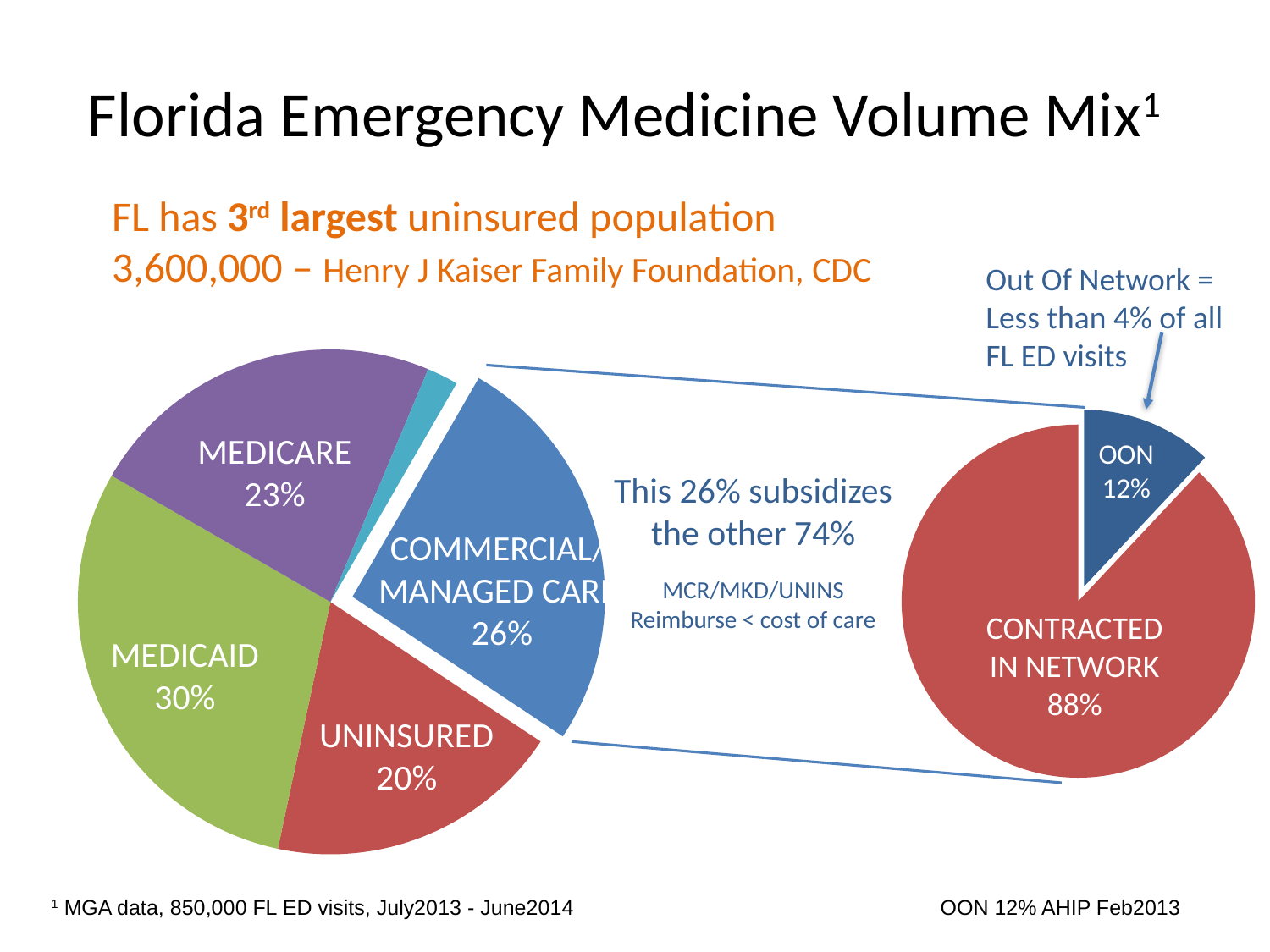
In the right pie chart, what share is OON? 12% In the left pie chart, what share of volume is Commercial/Managed Care? 26% In the left pie chart, which labeled category has the largest share? Medicaid In the left pie chart, what is the difference between the Medicaid share and the Uninsured share? 10% In the left pie chart, which is larger, the Commercial/Managed Care share or the Medicare share? Commercial/Managed Care In the left pie chart, which labeled category has the smallest share? Uninsured In the right pie chart, what share is Contracted In Network? 88% In the left pie chart, what share of volume is Medicaid? 30% In the left pie chart, what share of volume is Uninsured? 20% In the left pie chart, what share of volume is Medicare? 23% How many slices does the right pie chart have? 2 What kind of chart is the large chart on the left of the slide? Pie chart